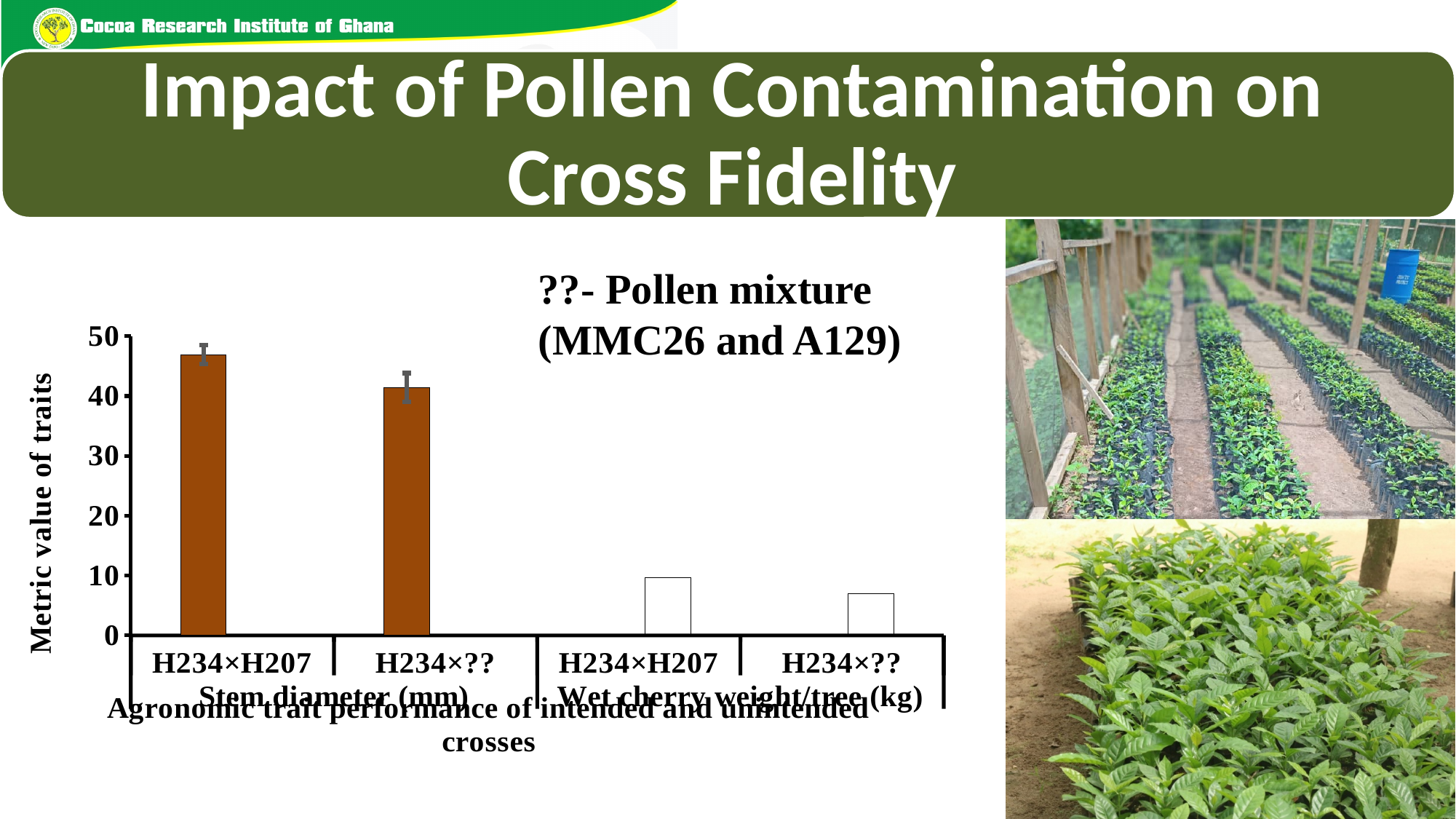
What is the title of the vertical axis of the chart? Metric value of traits Which bar is the highest in the chart? H234×H207 (Stem diameter (mm)) What kind of chart is shown on the slide? bar chart What colour are the stem diameter bars in the chart? brown How many bars are plotted in the chart? 4 Is the wet cherry weight/tree value for H234×H207 greater or less than 20? less Is the wet cherry weight/tree value for H234×?? greater or less than 10? less For stem diameter (mm), which cross has the larger value, H234×H207 or H234×??? H234×H207 Is the stem diameter value for H234×H207 greater or less than 40? greater For wet cherry weight/tree (kg), which cross has the larger value, H234×H207 or H234×??? H234×H207 Which bar is the lowest in the chart? H234×?? (Wet cherry weight/tree (kg))